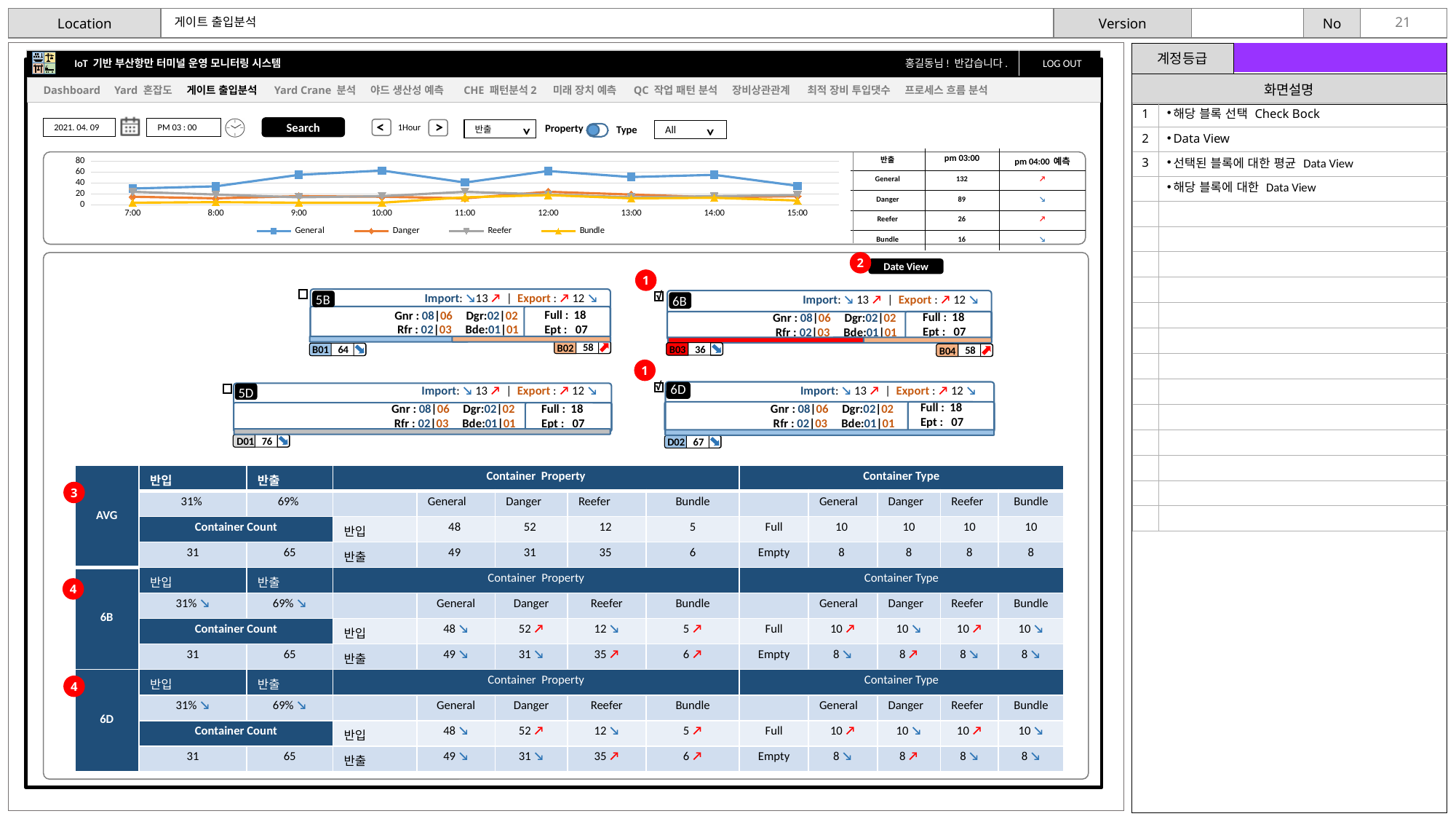
Which series has the highest values across the line chart? General How many series does the legend of the line chart list? 4 What is the first time label on the x axis of the line chart? 7:00 How many time points are plotted along the x axis of the line chart? 9 Is the value for General at 7:00 greater or less than 40? less What is the highest tick value shown on the y axis of the line chart? 80 Is the value for Bundle at 7:00 greater or less than 20? less Is the value for General at 10:00 greater or less than 40? greater At 12:00, which is larger on the line chart: General or Bundle? General What kind of chart is shown at the top of the slide? line chart